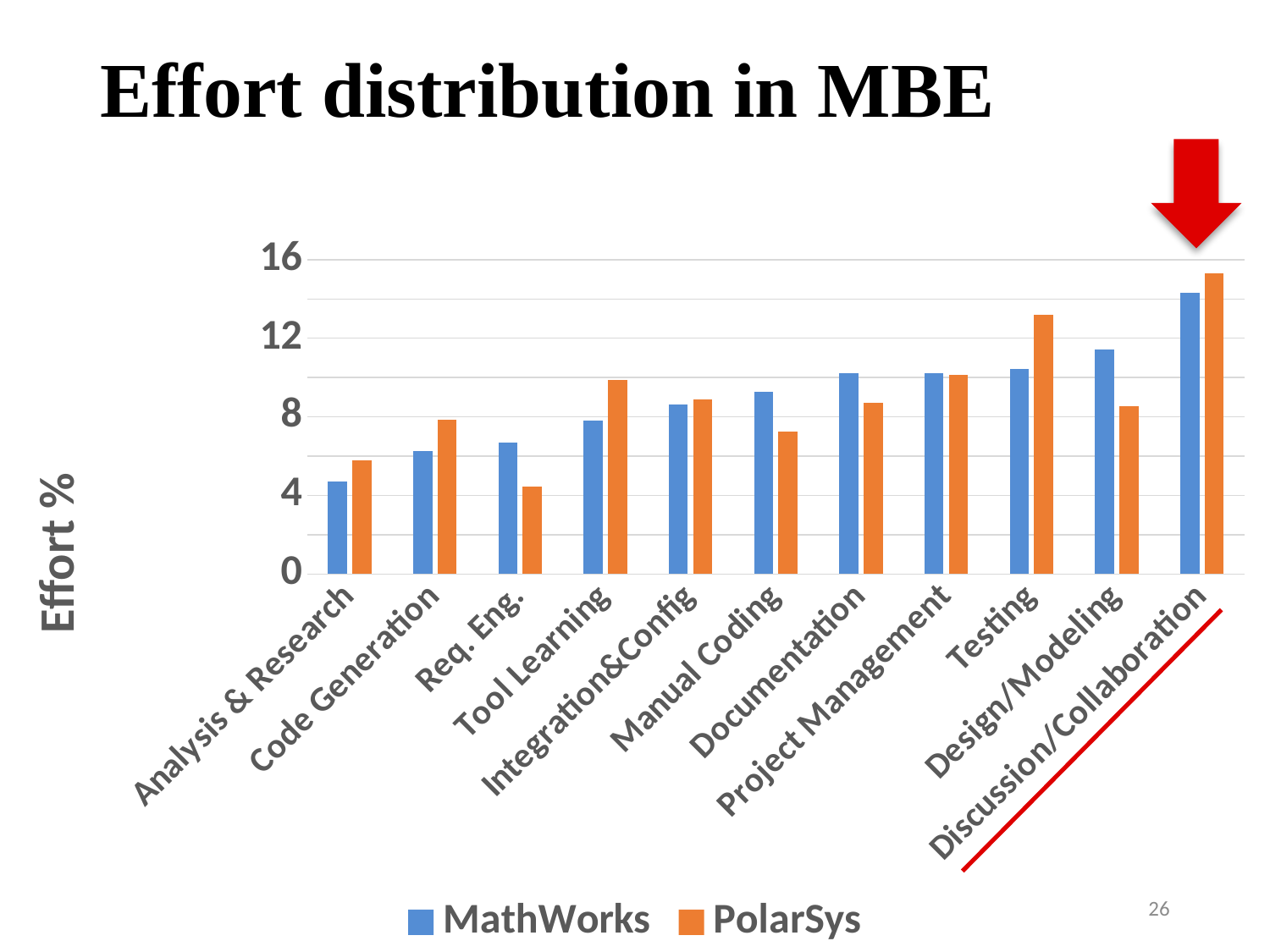
What kind of chart is shown on the slide? bar chart Which category has the highest MathWorks value? Discussion/Collaboration For Design/Modeling, which series has the larger value, MathWorks or PolarSys? MathWorks Is the PolarSys value for Testing greater or less than 12? greater What is the title of the y axis? Effort % How many series does the legend list? 2 Which category has the lowest MathWorks value? Analysis & Research Which category has the highest PolarSys value? Discussion/Collaboration Which category has the lowest PolarSys value? Req. Eng. Is the MathWorks value for Req. Eng. greater or less than 8? less For Testing, which series has the larger value, MathWorks or PolarSys? PolarSys How many categories are shown on the x axis? 11